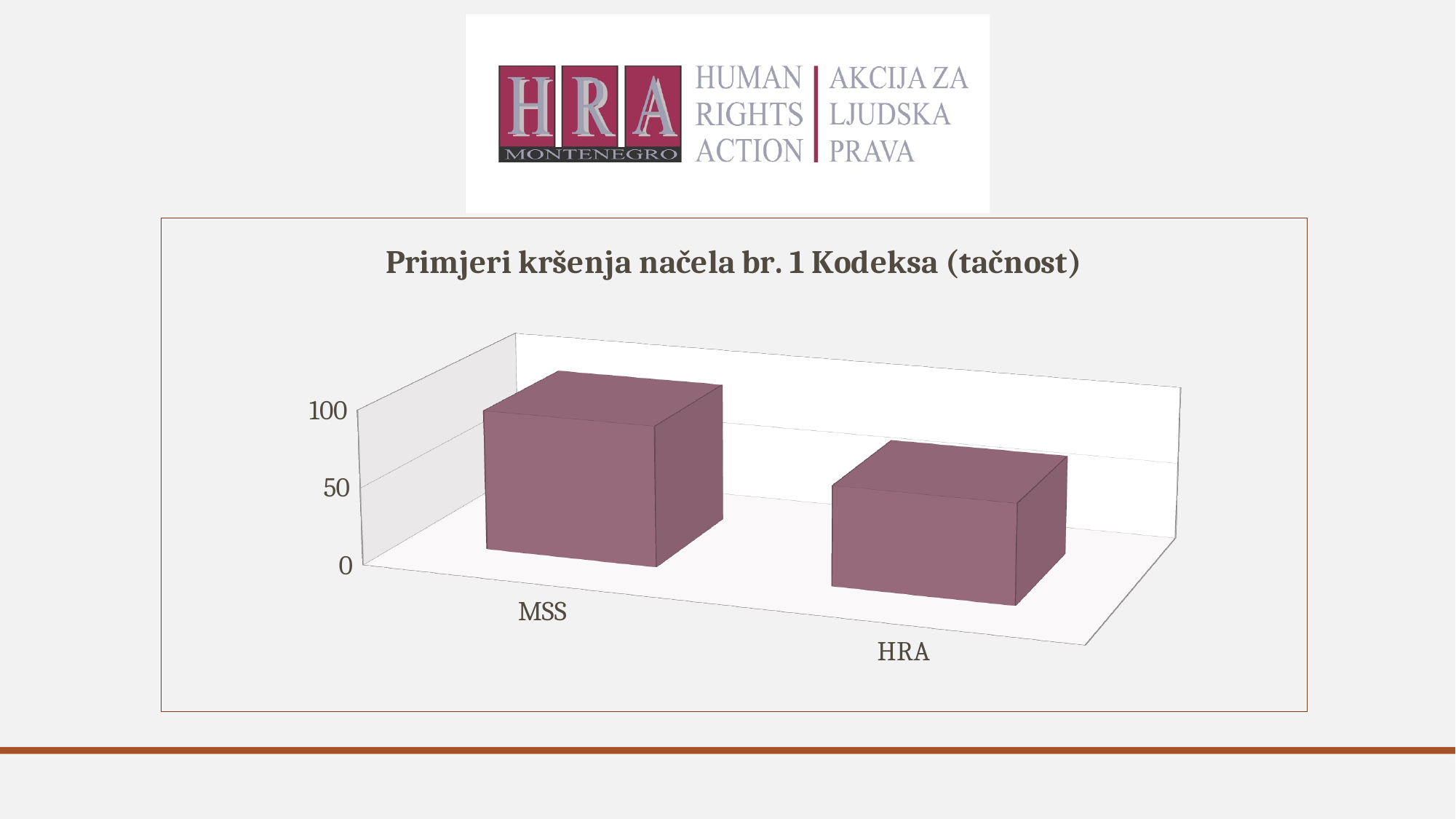
What is the title of the chart? Primjeri kršenja načela br. 1 Kodeksa (tačnost) Is the value for HRA greater or less than 100? less How many categories are shown on the chart? 2 Is the value for MSS greater or less than 50? greater Is the value for HRA greater or less than 50? greater What kind of chart is shown on the slide? bar chart Which is larger, the value for MSS or the value for HRA? MSS Which category has the lowest value? HRA Which category has the highest value? MSS What is the highest value shown on the vertical axis? 100 Do the values rise or fall from MSS to HRA along the x axis? fall